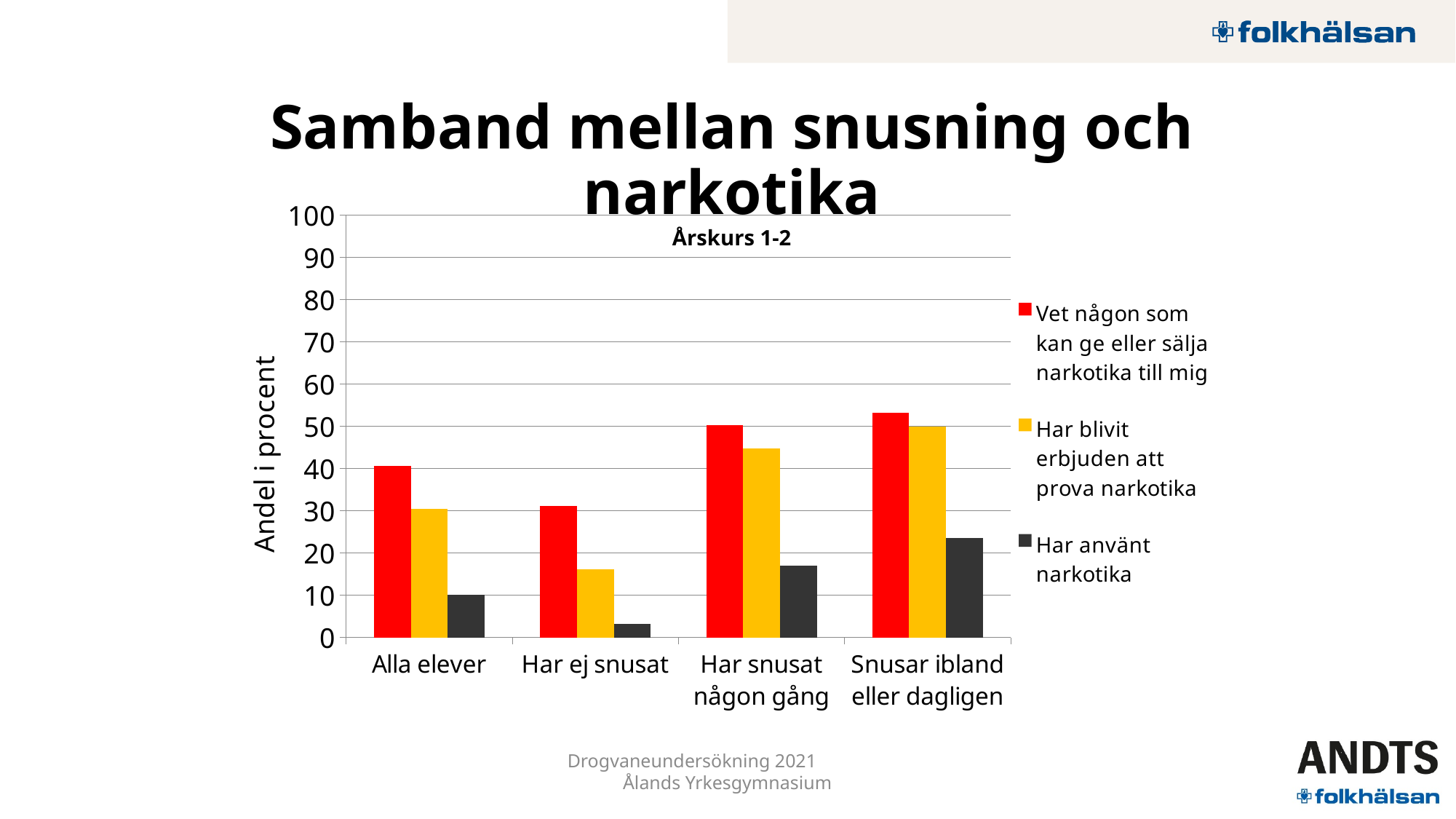
Is the value for 'Har blivit erbjuden att prova narkotika' in the 'Har snusat någon gång' category greater or less than 40? greater Is the value for 'Har använt narkotika' in the 'Har ej snusat' category greater or less than 10? less How many series does the chart's legend list? 3 What kind of chart is shown on the slide? bar chart Is the value for 'Har använt narkotika' in the 'Snusar ibland eller dagligen' category greater or less than 20? greater How many categories are shown on the x axis of the chart? 4 For 'Alla elever', which is larger: 'Vet någon som kan ge eller sälja narkotika till mig' or 'Har blivit erbjuden att prova narkotika'? Vet någon som kan ge eller sälja narkotika till mig Which category has the lowest value for 'Vet någon som kan ge eller sälja narkotika till mig'? Har ej snusat Which category has the lowest value for 'Har använt narkotika'? Har ej snusat Which category has the highest value for 'Har använt narkotika'? Snusar ibland eller dagligen What is the label on the y axis of the chart? Andel i procent Does the value for 'Har använt narkotika' rise or fall from 'Har ej snusat' to 'Snusar ibland eller dagligen'? rise